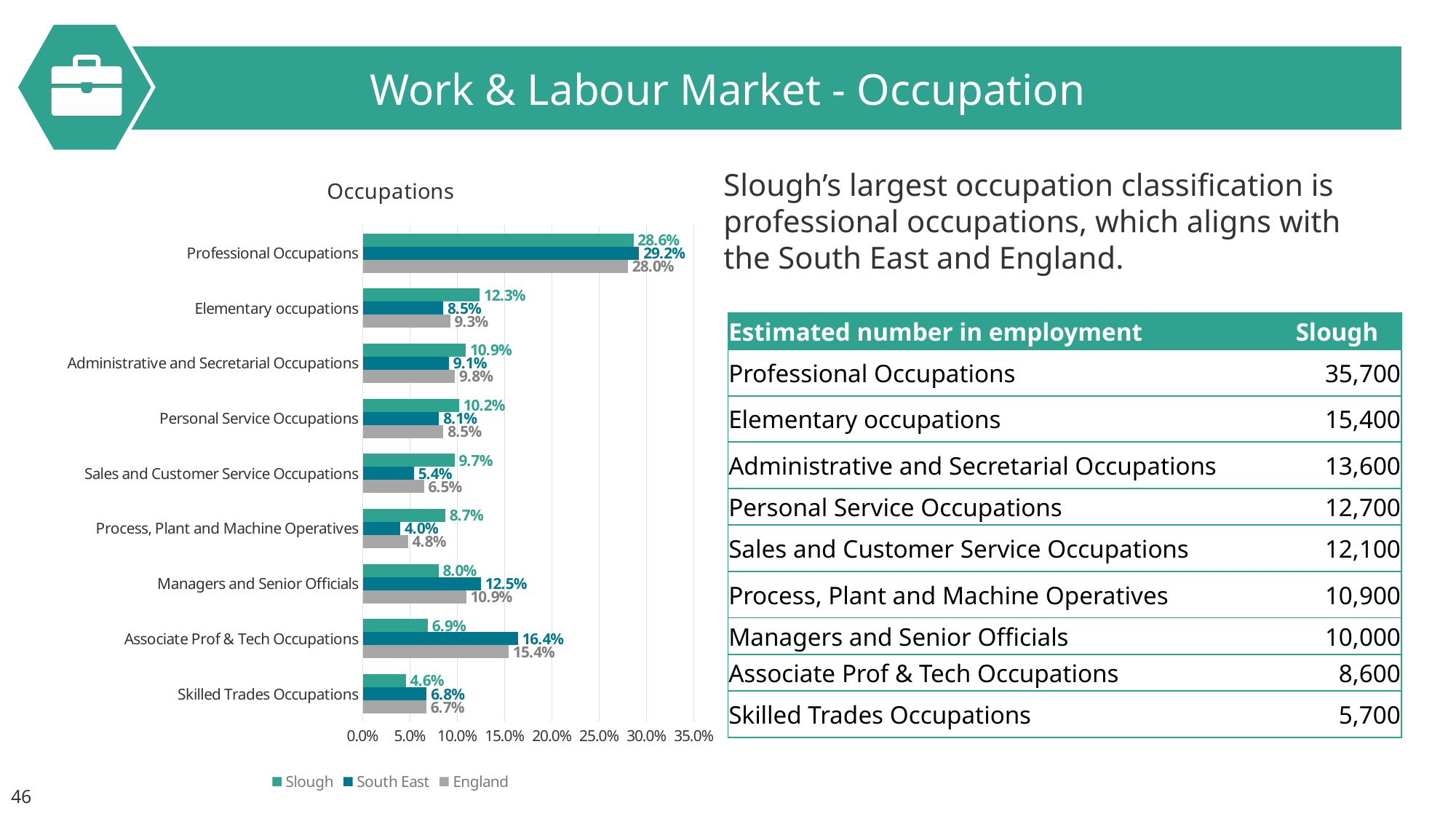
What is the title of the chart? Occupations What is the England value for Process, Plant and Machine Operatives? 4.8% How many occupation categories are shown in the chart? 9 What is the difference between the Slough and South East values for Elementary occupations? 3.8% How many series does the chart legend list? 3 What is the South East value for Associate Prof & Tech Occupations? 16.4% Is the South East value for Professional Occupations greater or less than 25.0%? greater What is the Slough value for Professional Occupations? 28.6% Which is larger for Managers and Senior Officials, the Slough value or the South East value? South East Which occupation category has the lowest Slough value? Skilled Trades Occupations What type of chart is shown on the slide? bar chart Which occupation category has the highest Slough value? Professional Occupations